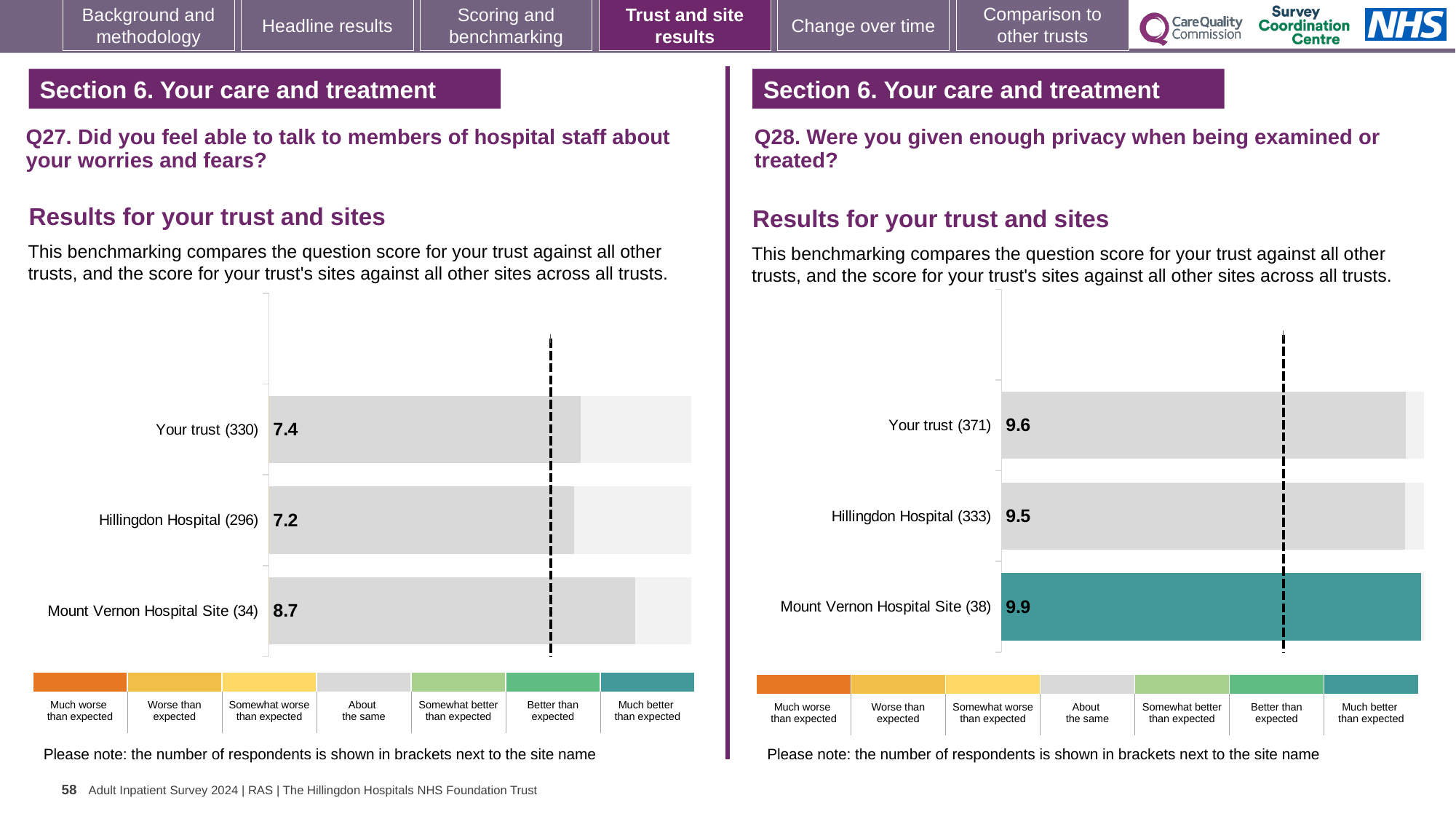
On the Q27 chart (left), what is the difference between the scores for Mount Vernon Hospital Site and Hillingdon Hospital? 1.5 What kind of chart is used on the Q27 chart (left)? Bar chart On the Q27 chart (left), which site or trust has the lowest score? Hillingdon Hospital On the Q28 chart (right), which site or trust has the highest score? Mount Vernon Hospital Site On the Q28 chart (right), which benchmark category does the colour of the Mount Vernon Hospital Site bar correspond to? Much better than expected On the Q28 chart (right), what is the score for Hillingdon Hospital? 9.5 On the Q28 chart (right), what is the difference between the scores for Your trust and Hillingdon Hospital? 0.1 On the Q28 chart (right), what is the score for Mount Vernon Hospital Site? 9.9 On the Q27 chart (left), what is the score for Your trust? 7.4 On the Q27 chart (left), what is the score for Mount Vernon Hospital Site? 8.7 On the Q28 chart (right), how many bars are plotted? 3 On the Q27 chart (left), which site or trust has the highest score? Mount Vernon Hospital Site